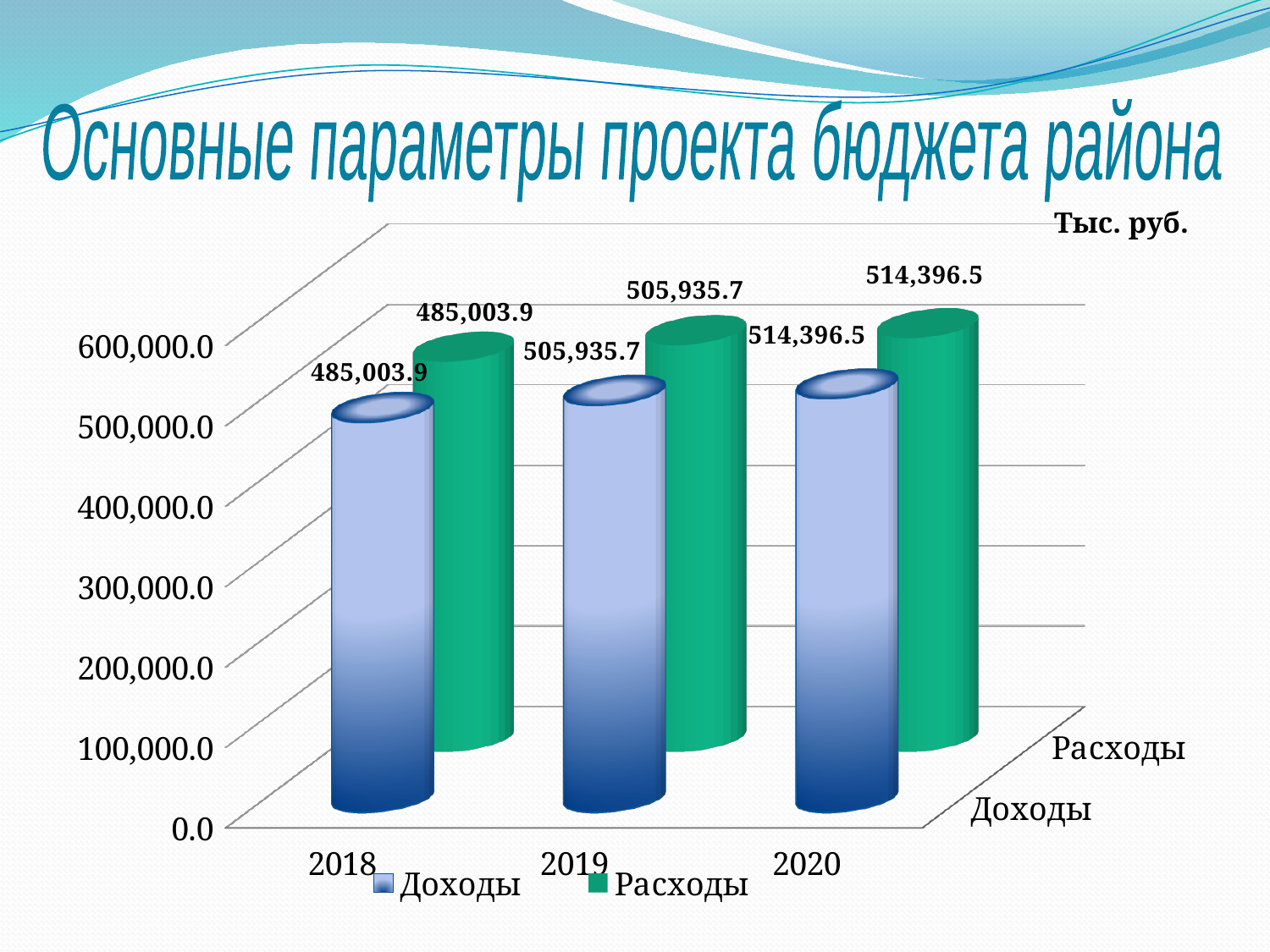
How many series does the legend list? 2 What is the value of Расходы for 2019? 505,935.7 What is the value of Доходы for 2018? 485,003.9 Do the values of Доходы rise or fall from 2018 to 2020? rise What is the difference between Расходы in 2020 and Расходы in 2019? 8,460.8 What is the value of Расходы for 2018? 485,003.9 Which is larger: Расходы in 2020 or Расходы in 2018? Расходы in 2020 What is the difference between Доходы in 2019 and Доходы in 2018? 20,931.8 What is the value of Доходы for 2020? 514,396.5 Which year has the highest value of Доходы? 2020 Which year has the lowest value of Расходы? 2018 How many years are shown on the x axis? 3